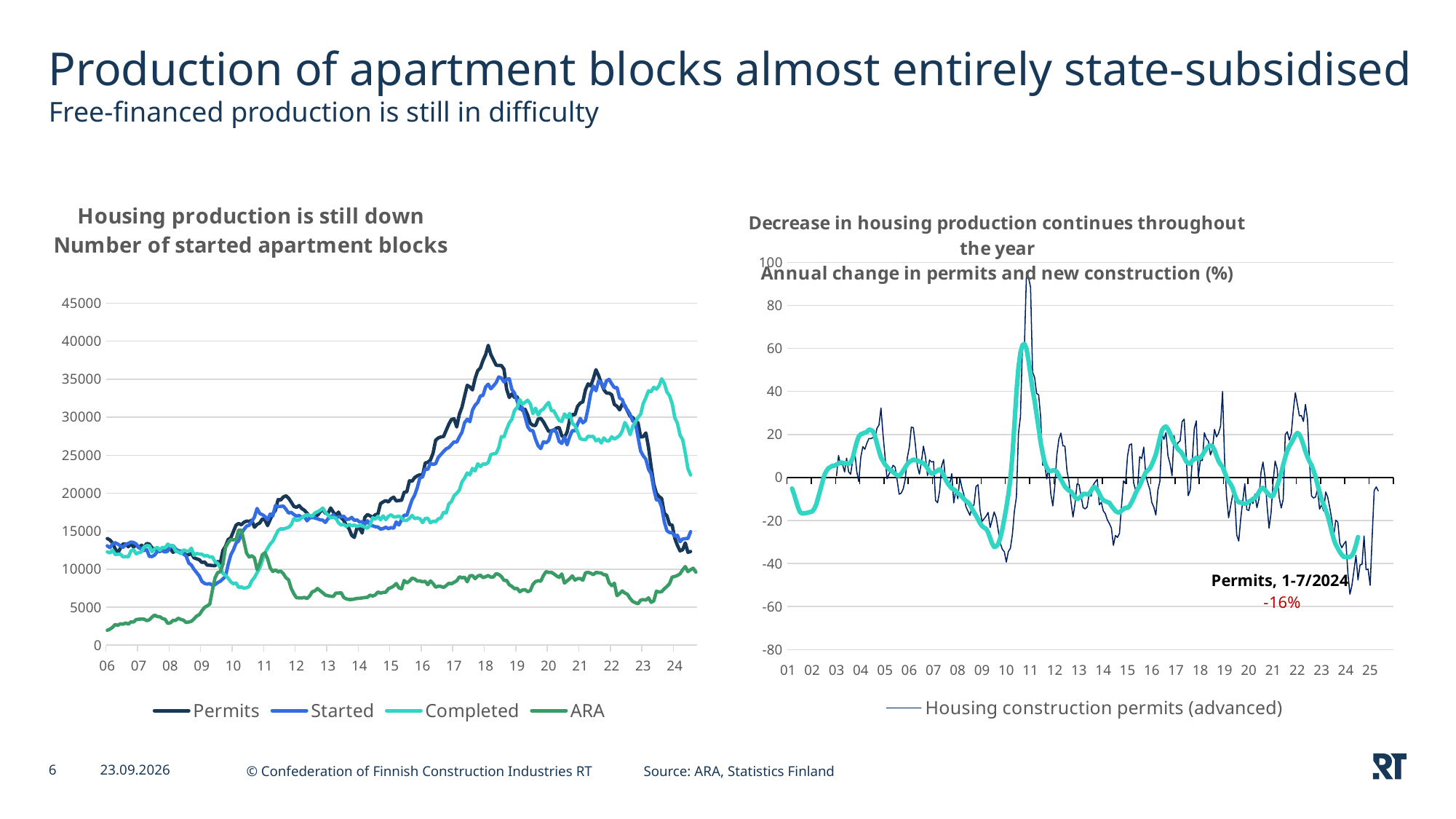
In the left chart, 'Housing production is still down', is the peak value of Permits around 2018 greater or less than 35000? greater What are the legend entries of the left chart, 'Housing production is still down'? Permits, Started, Completed, ARA What kind of chart is the left chart, 'Housing production is still down'? line chart How many series does the legend of the left chart, 'Housing production is still down', list? 4 In the left chart, 'Housing production is still down', does the ARA series rise or fall between 2006 and 2010? rise In the right chart, 'Decrease in housing production continues throughout the year', is the peak value of the thin permits line around 2011 greater or less than 80? greater In the left chart, 'Housing production is still down', which series has the highest value around 2018? Permits In the left chart, 'Housing production is still down', which series has the lowest value around 2018? ARA In the right chart, 'Decrease in housing production continues throughout the year', what is the annual change in permits for 1-7/2024? -16% In the left chart, 'Housing production is still down', is the peak value of Completed around 2023 greater or less than 30000? greater How many series does the legend of the right chart, 'Decrease in housing production continues throughout the year', list? 1